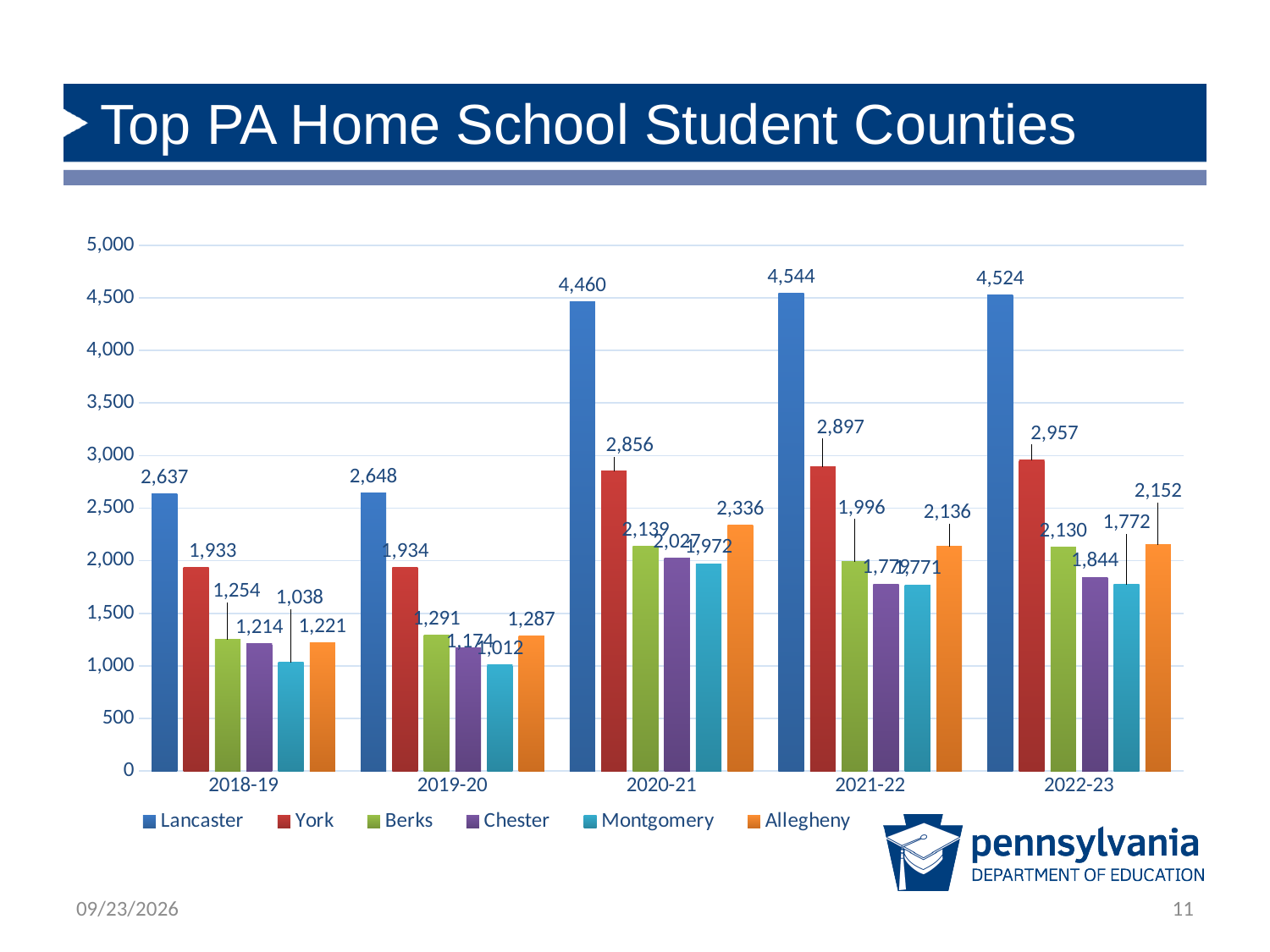
Which county has the lowest value in 2018-19? Montgomery What kind of chart is shown on the slide? bar chart In which school year is the Lancaster value highest? 2021-22 What is the value for Allegheny in 2020-21? 2,336 How many school years are shown on the x axis? 5 What is the value for York in 2022-23? 2,957 How many counties does the legend list? 6 What is the difference between the Lancaster values for 2021-22 and 2020-21? 84 Is the value for York in 2019-20 greater or less than 2,000? less Which is larger, the Allegheny value for 2022-23 or for 2021-22? 2022-23 Does the Lancaster value rise or fall from 2018-19 to 2021-22? rise What is the value for Lancaster in 2021-22? 4,544